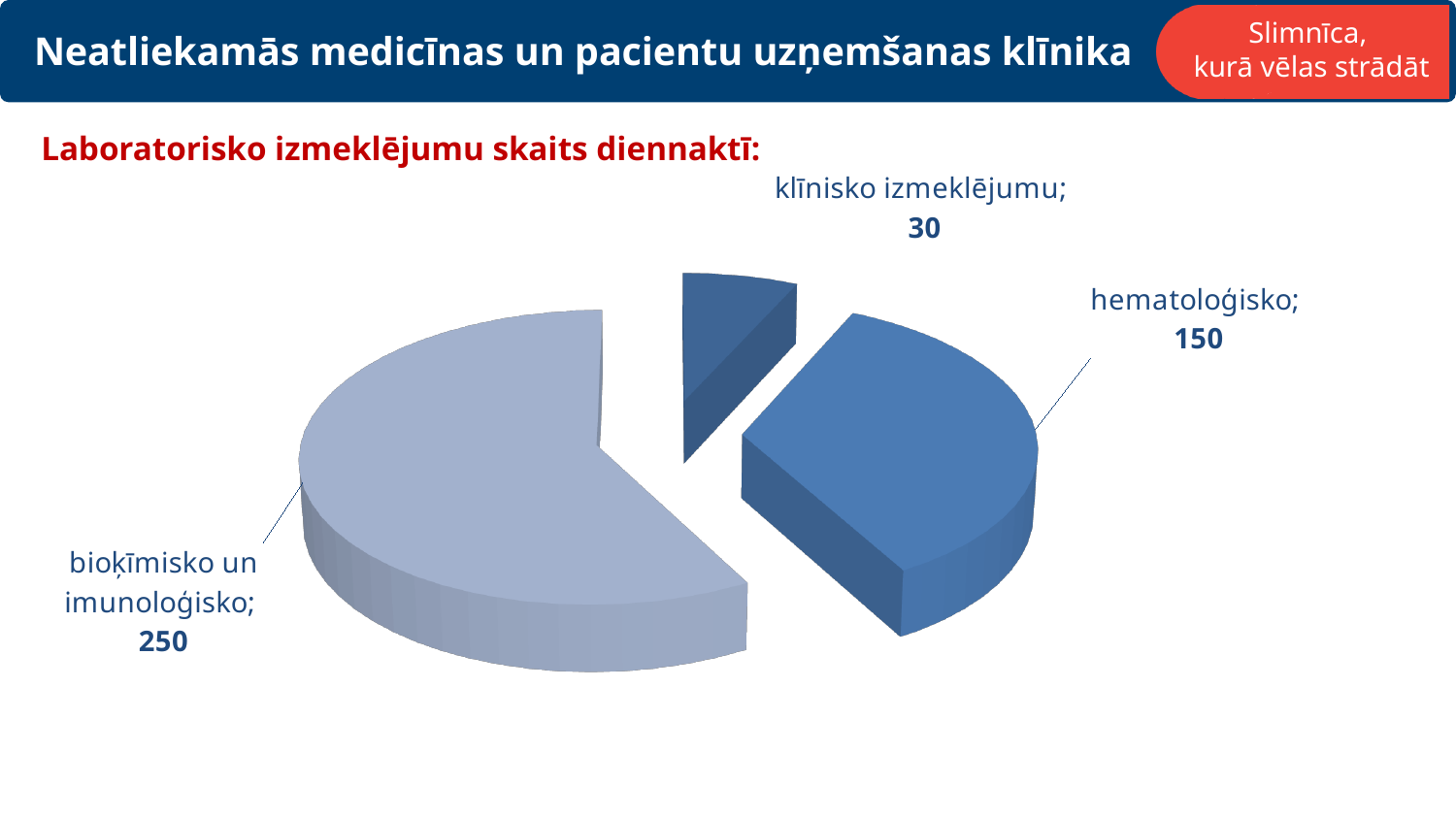
What is the difference between the values for hematoloģisko and klīnisko izmeklējumu? 120 What is the total of all slices in the pie chart? 430 What is the value for bioķīmisko un imunoloģisko? 250 What is the difference between the values for bioķīmisko un imunoloģisko and hematoloģisko? 100 How many slices does the pie chart have? 3 Which category has the smallest slice? klīnisko izmeklējumu Which is larger, the value for hematoloģisko or the value for klīnisko izmeklējumu? hematoloģisko What is the value for klīnisko izmeklējumu? 30 What kind of chart is shown on the slide? pie chart What is the value for hematoloģisko? 150 Which category has the largest slice? bioķīmisko un imunoloģisko What is the title of the chart? Laboratorisko izmeklējumu skaits diennaktī